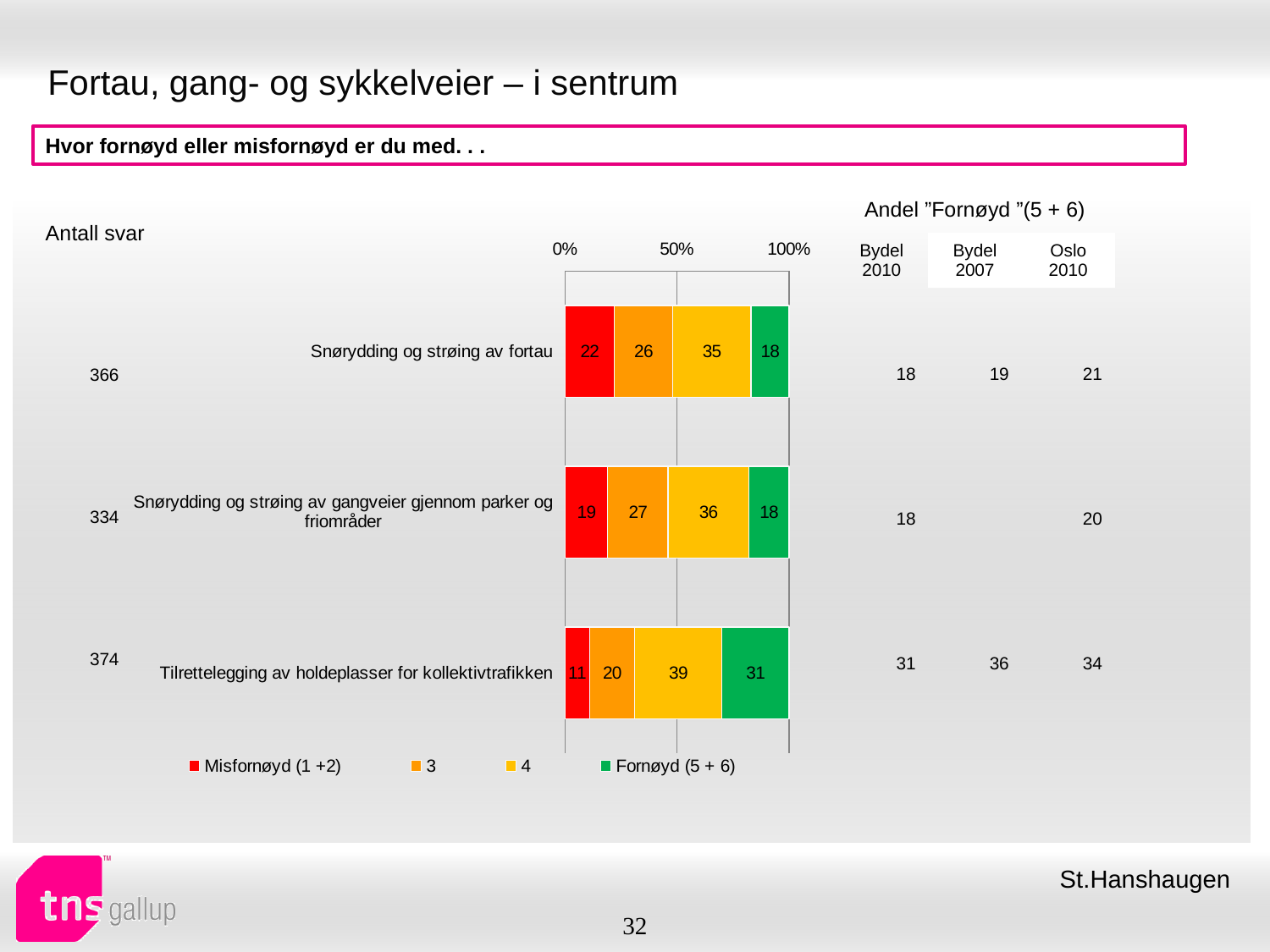
Which category has the highest Fornøyd (5 + 6) value? Tilrettelegging av holdeplasser for kollektivtrafikken What is the value of the Fornøyd (5 + 6) segment for "Tilrettelegging av holdeplasser for kollektivtrafikken"? 31 What is the value of the Misfornøyd (1 +2) segment for "Snørydding og strøing av fortau"? 22 What is the difference between the "4" segment for "Tilrettelegging av holdeplasser for kollektivtrafikken" and the "4" segment for "Snørydding og strøing av fortau"? 4 How many series does the legend list? 4 How much larger is the Fornøyd (5 + 6) value for "Tilrettelegging av holdeplasser for kollektivtrafikken" than for "Snørydding og strøing av fortau"? 13 What kind of chart is shown on the slide? Stacked bar chart Which category has the lowest Misfornøyd (1 +2) value? Tilrettelegging av holdeplasser for kollektivtrafikken How many categories are shown in the chart? 3 What is the value of the "4" segment for "Snørydding og strøing av gangveier gjennom parker og friområder"? 36 Which legend entry is shown in red? Misfornøyd (1 +2) Which has the larger Misfornøyd (1 +2) value: "Snørydding og strøing av fortau" or "Snørydding og strøing av gangveier gjennom parker og friområder"? Snørydding og strøing av fortau